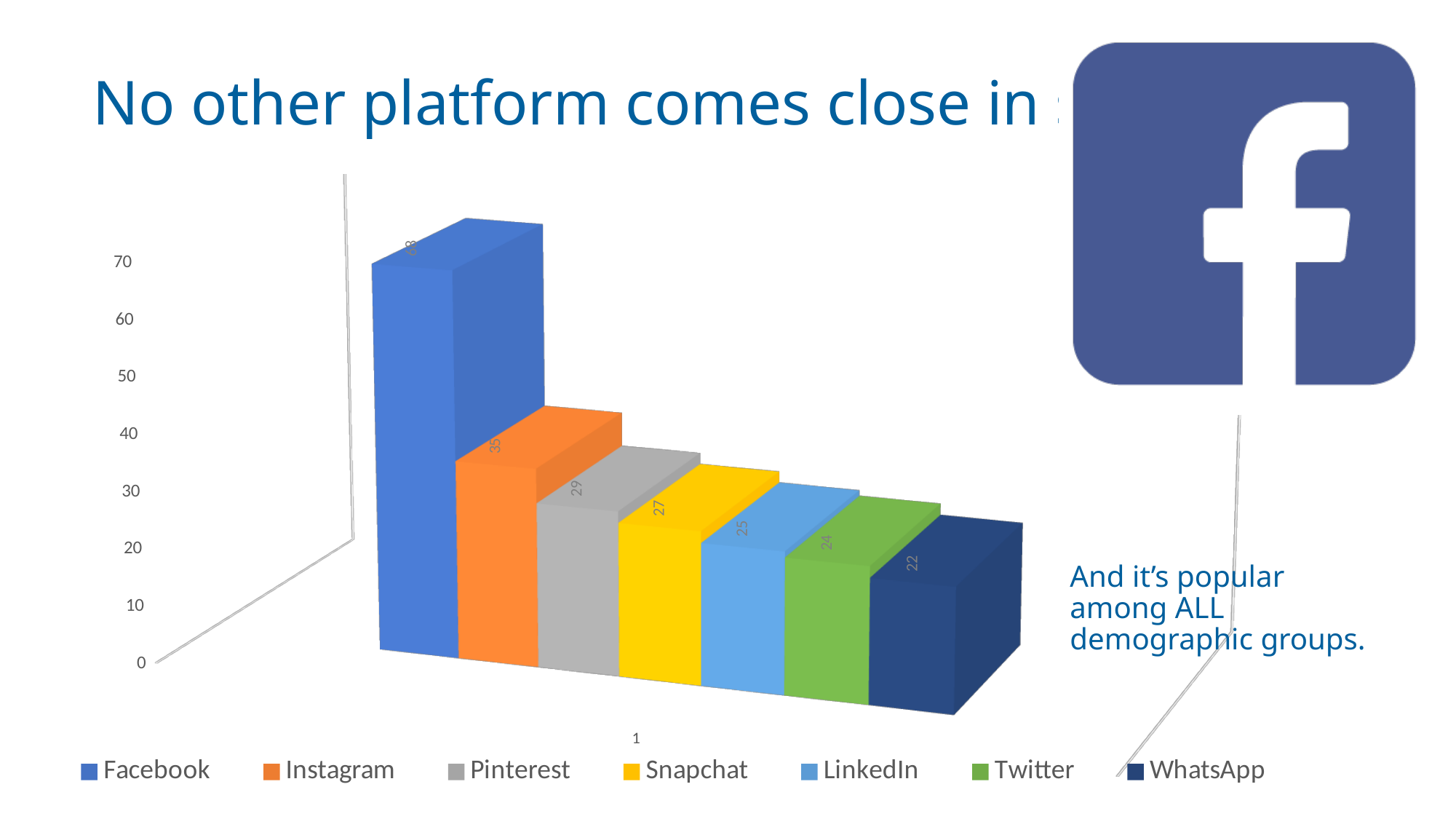
How many series does the legend list? 7 Which platform has the lowest value? WhatsApp Which platform has the highest value? Facebook What is the value for Instagram? 35 What is the value for Snapchat? 27 What is the difference between the values for Instagram and WhatsApp? 13 What is the value for WhatsApp? 22 What kind of chart is shown on the slide? bar chart What is the value for Pinterest? 29 Is the value for Facebook greater or less than 60? greater Which is larger, the value for Pinterest or the value for Snapchat? Pinterest What is the value for LinkedIn? 25